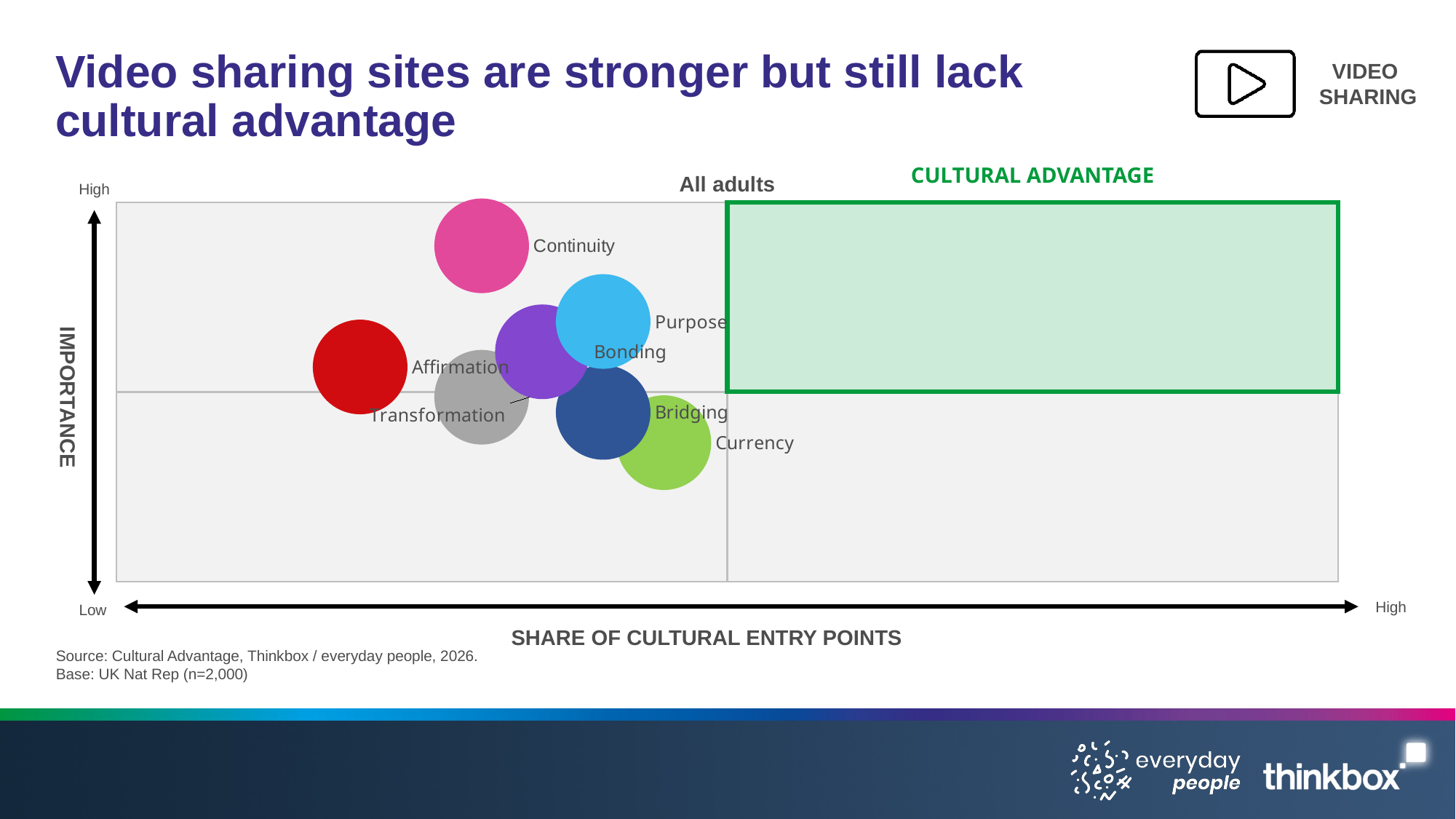
Which bubble is positioned highest on the Importance axis? Continuity How many labelled bubbles are plotted on the chart? 7 Which bubble is positioned lowest on the Importance axis? Currency What kind of chart is shown on the slide? bubble chart Which bubble is coloured pink? Continuity How many bubbles fall inside the green Cultural Advantage area? 0 Which bubble is positioned furthest to the right on the Share of Cultural Entry Points axis? Currency What is the label of the vertical axis? IMPORTANCE Which is higher on the Importance axis, Continuity or Currency? Continuity Which is higher on the Importance axis, Purpose or Bridging? Purpose What is the label of the horizontal axis? SHARE OF CULTURAL ENTRY POINTS